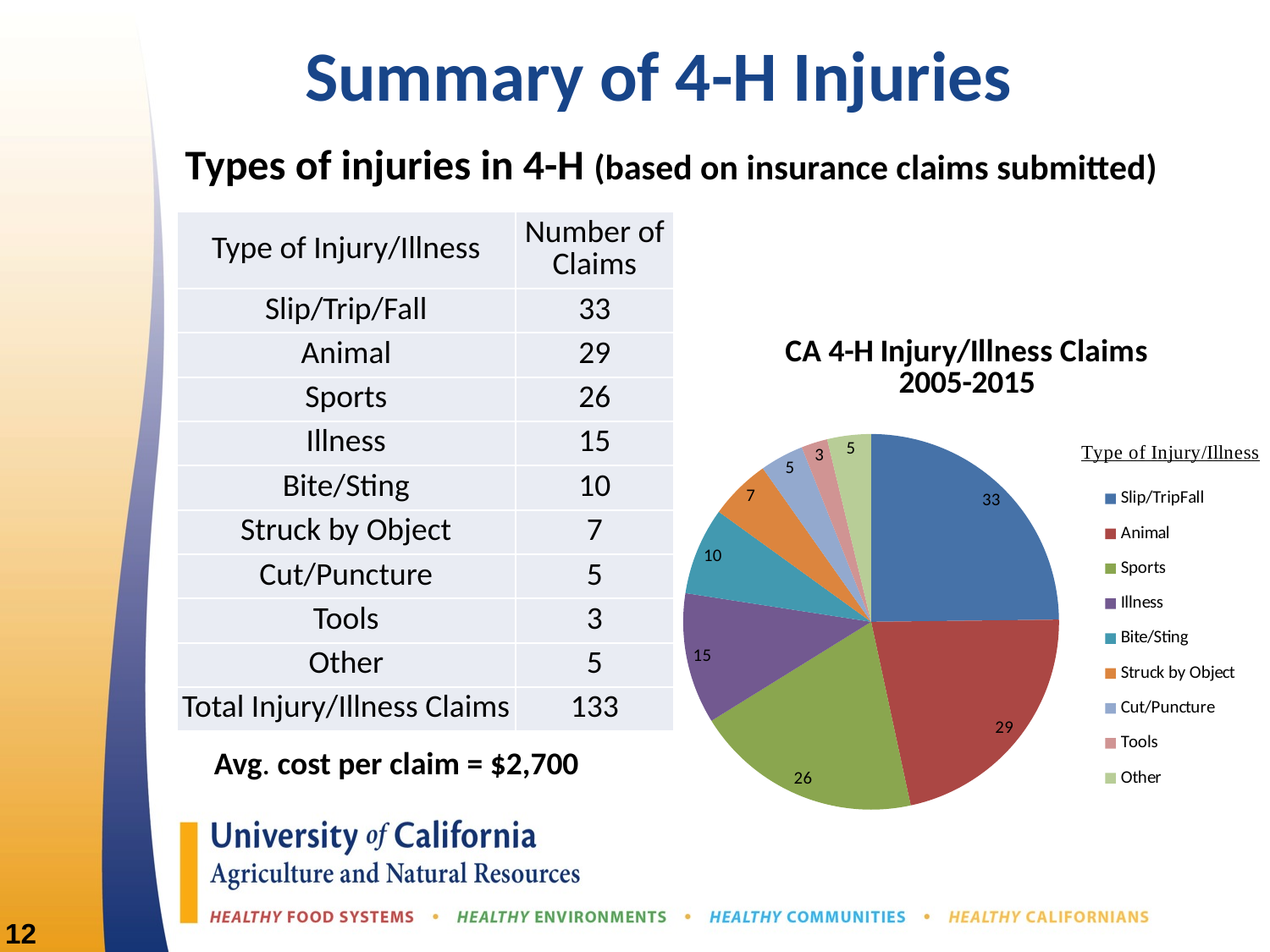
What type of chart is shown on the slide? pie chart What is the difference between the Slip/TripFall and Sports values in the pie chart? 7 How many entries does the pie chart legend list? 9 What is the value of the Animal slice in the pie chart? 29 What is the title of the pie chart? CA 4-H Injury/Illness Claims 2005-2015 What is the value of the Struck by Object slice in the pie chart? 7 Which is larger in the pie chart, Illness or Bite/Sting? Illness How many slices does the pie chart have? 9 What is the total of all the slices in the pie chart? 133 What is the value of the Bite/Sting slice in the pie chart? 10 Which category has the smallest slice in the pie chart? Tools Which category has the largest slice in the pie chart? Slip/TripFall